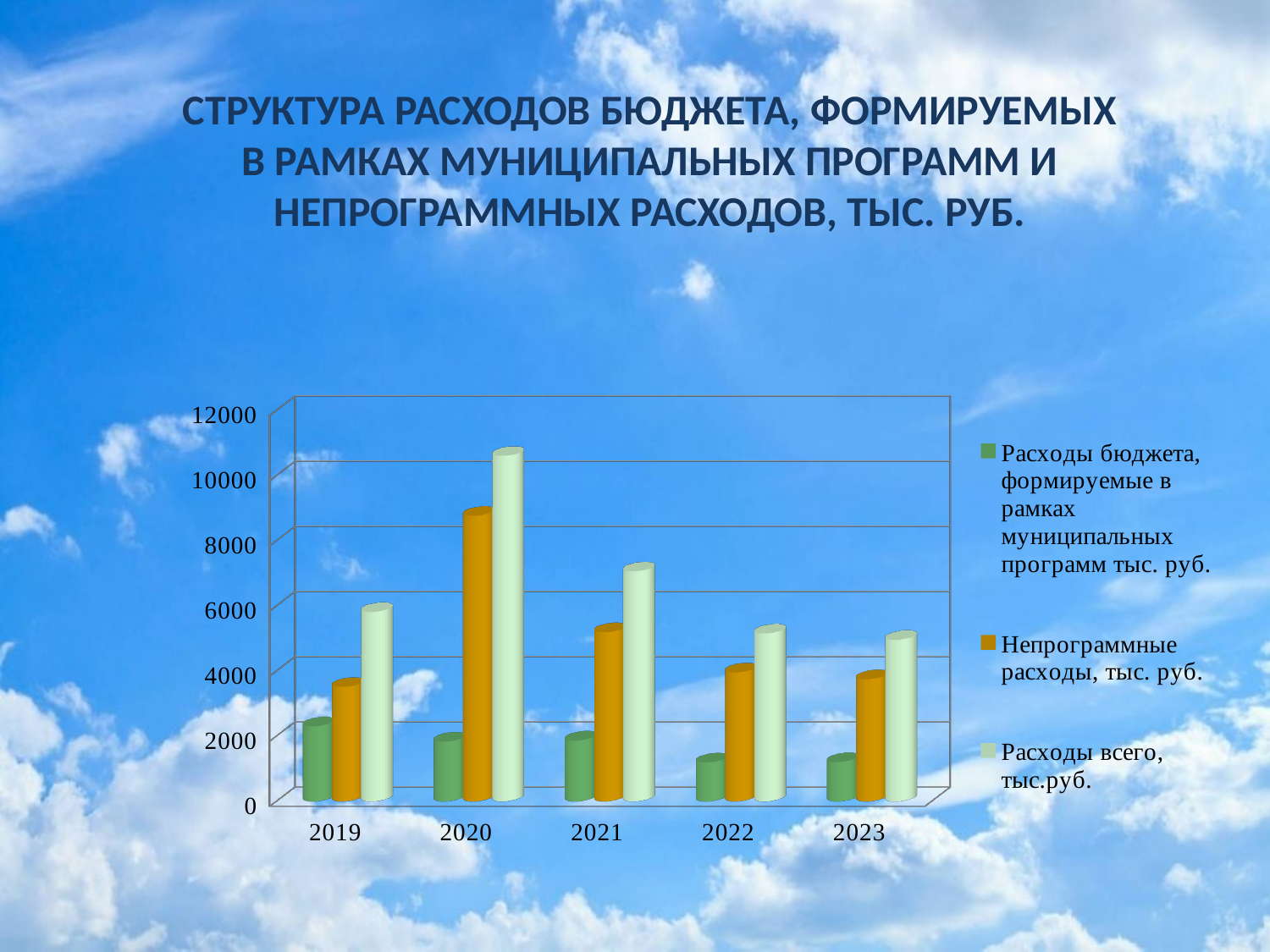
Which is larger: Непрограммные расходы in 2020 or in 2021? 2020 Which series is shown in orange in the chart legend? Непрограммные расходы, тыс. руб. In which year is the value for Расходы бюджета, формируемые в рамках муниципальных программ the highest? 2019 How many years are shown on the x axis of the chart? 5 In which year is the value for Расходы всего, тыс.руб. the highest? 2020 In which year is the value for Непрограммные расходы, тыс. руб. the highest? 2020 Is the value for Расходы бюджета, формируемые в рамках муниципальных программ in 2022 greater or less than 2000? less Is the value for Расходы всего in 2023 greater or less than 6000? less How many series does the chart legend list? 3 What kind of chart is shown on the slide? bar chart Is the value for Расходы всего in 2020 greater or less than 10000? greater